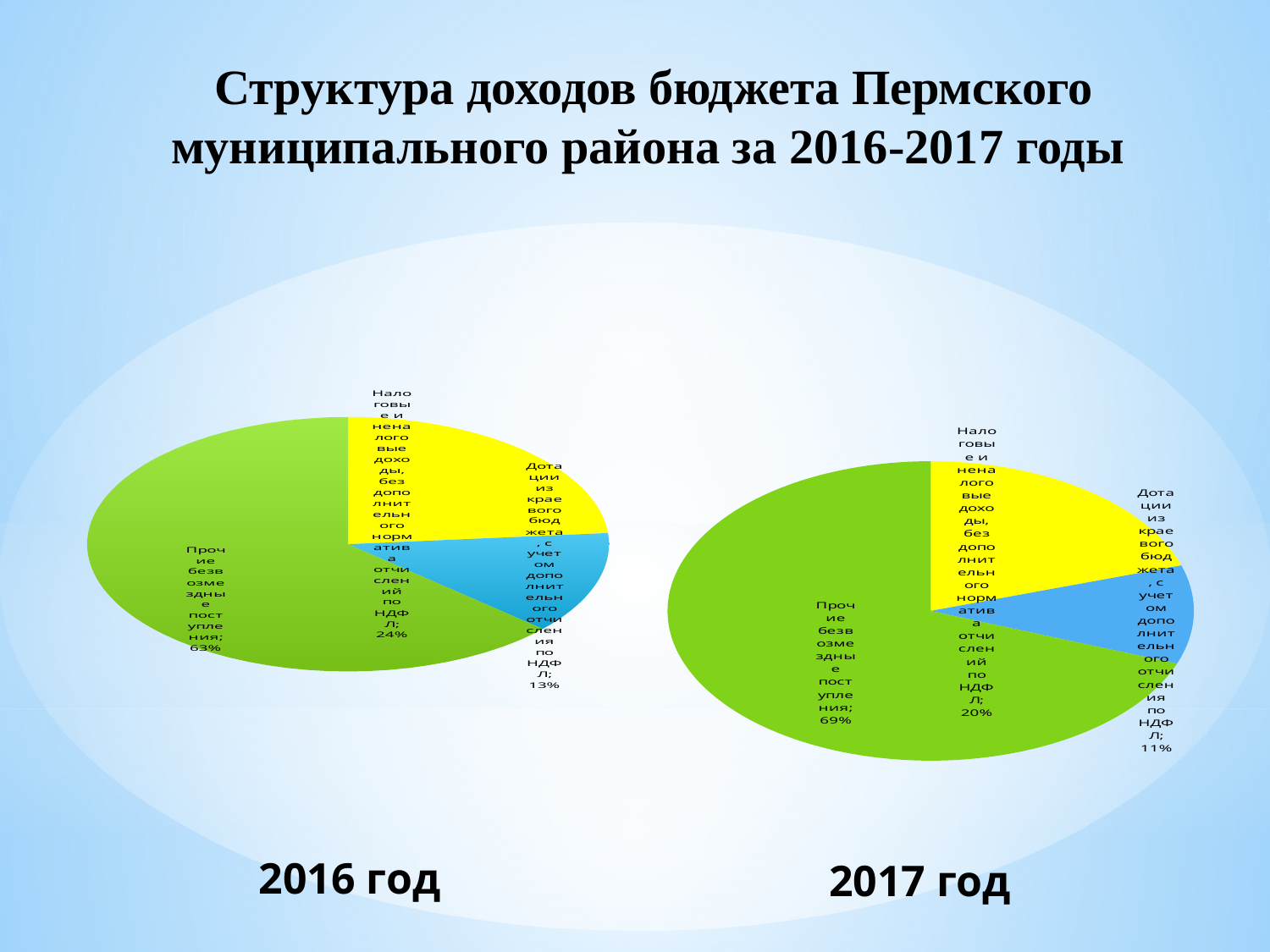
Which is larger: the share of Налоговые и неналоговые доходы in the 2016 год chart or in the 2017 год chart? 2016 год In the 2016 год pie chart, what share is shown for Прочие безвозмездные поступления? 63% How many slices does the 2017 год pie chart have? 3 In the 2016 год pie chart, what share is shown for Дотации из краевого бюджета, с учетом дополнительного норматива отчислений по НДФЛ? 13% In the 2017 год pie chart, what share is shown for Дотации из краевого бюджета, с учетом дополнительного норматива отчислений по НДФЛ? 11% In the 2017 год pie chart, which category has the smallest share? Дотации из краевого бюджета, с учетом дополнительного норматива отчислений по НДФЛ In the 2017 год pie chart, what share is shown for Прочие безвозмездные поступления? 69% In the 2016 год pie chart, what share is shown for Налоговые и неналоговые доходы, без дополнительного норматива отчислений по НДФЛ? 24% What is the difference between the share of Прочие безвозмездные поступления in the 2017 год chart and in the 2016 год chart? 6% In the 2017 год pie chart, what share is shown for Налоговые и неналоговые доходы, без дополнительного норматива отчислений по НДФЛ? 20% What type of chart is used for the 2016 год data? Pie chart In the 2016 год pie chart, which category has the largest share? Прочие безвозмездные поступления